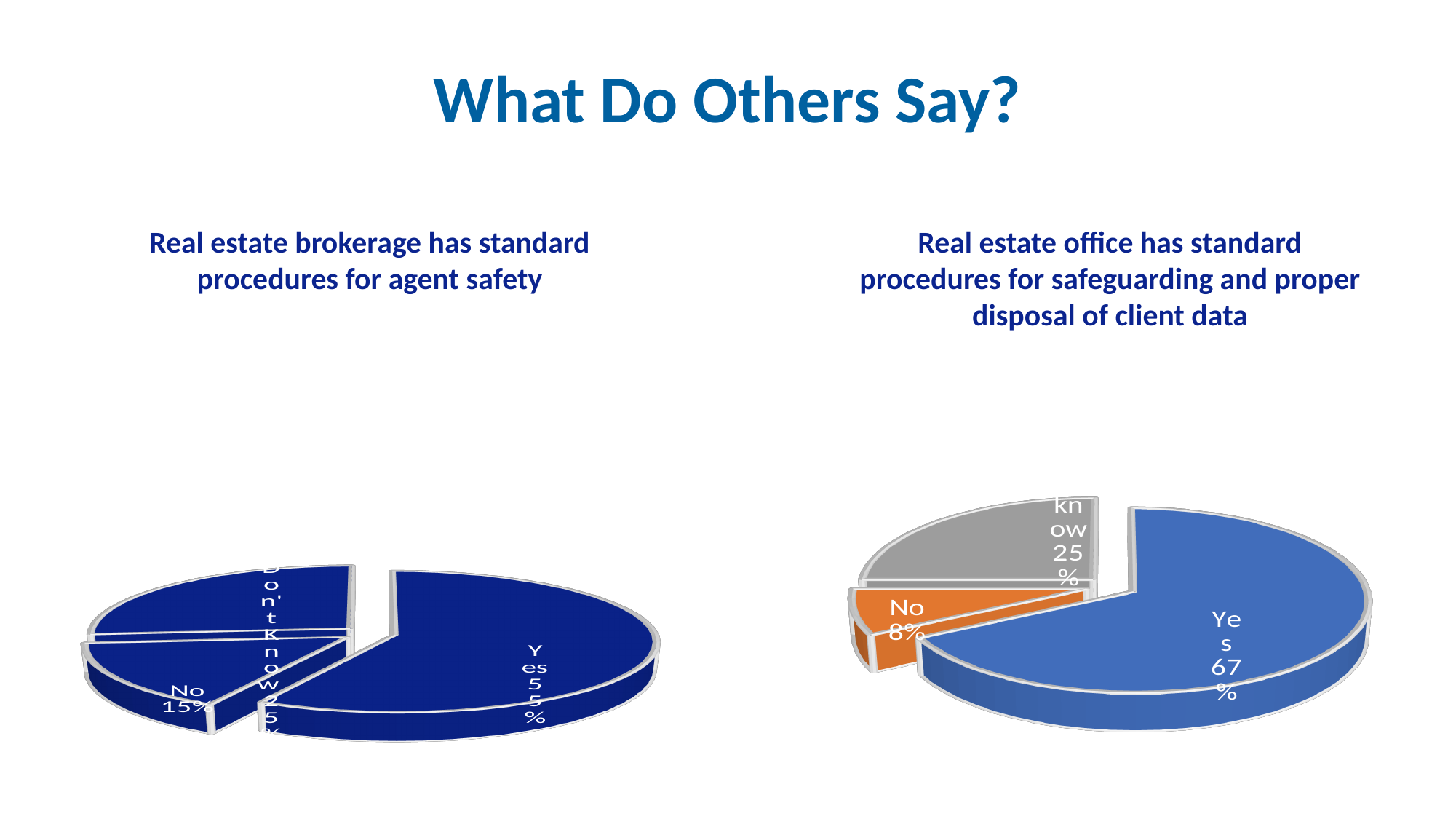
Is the Yes percentage larger in the left-hand chart (agent safety) or the right-hand chart (safeguarding client data)? Right-hand chart (safeguarding client data) In the pie chart titled "Real estate office has standard procedures for safeguarding and proper disposal of client data", what percentage answered Yes? 67% In the pie chart titled "Real estate brokerage has standard procedures for agent safety", what percentage answered No? 15% How many slices does the right-hand pie chart about safeguarding client data have? 3 In the pie chart titled "Real estate brokerage has standard procedures for agent safety", what percentage answered Yes? 55% In the right-hand pie chart about safeguarding client data, which response has the largest slice? Yes In the pie chart titled "Real estate office has standard procedures for safeguarding and proper disposal of client data", what percentage answered Don't know? 25% In the right-hand pie chart about safeguarding client data, which response has the smallest slice? No In the pie chart titled "Real estate office has standard procedures for safeguarding and proper disposal of client data", what percentage answered No? 8% In the left-hand pie chart about agent safety, which response has the largest slice? Yes What type of chart is used on this slide? Pie chart In the right-hand pie chart about safeguarding client data, what is the difference between the Yes and No percentages? 59%